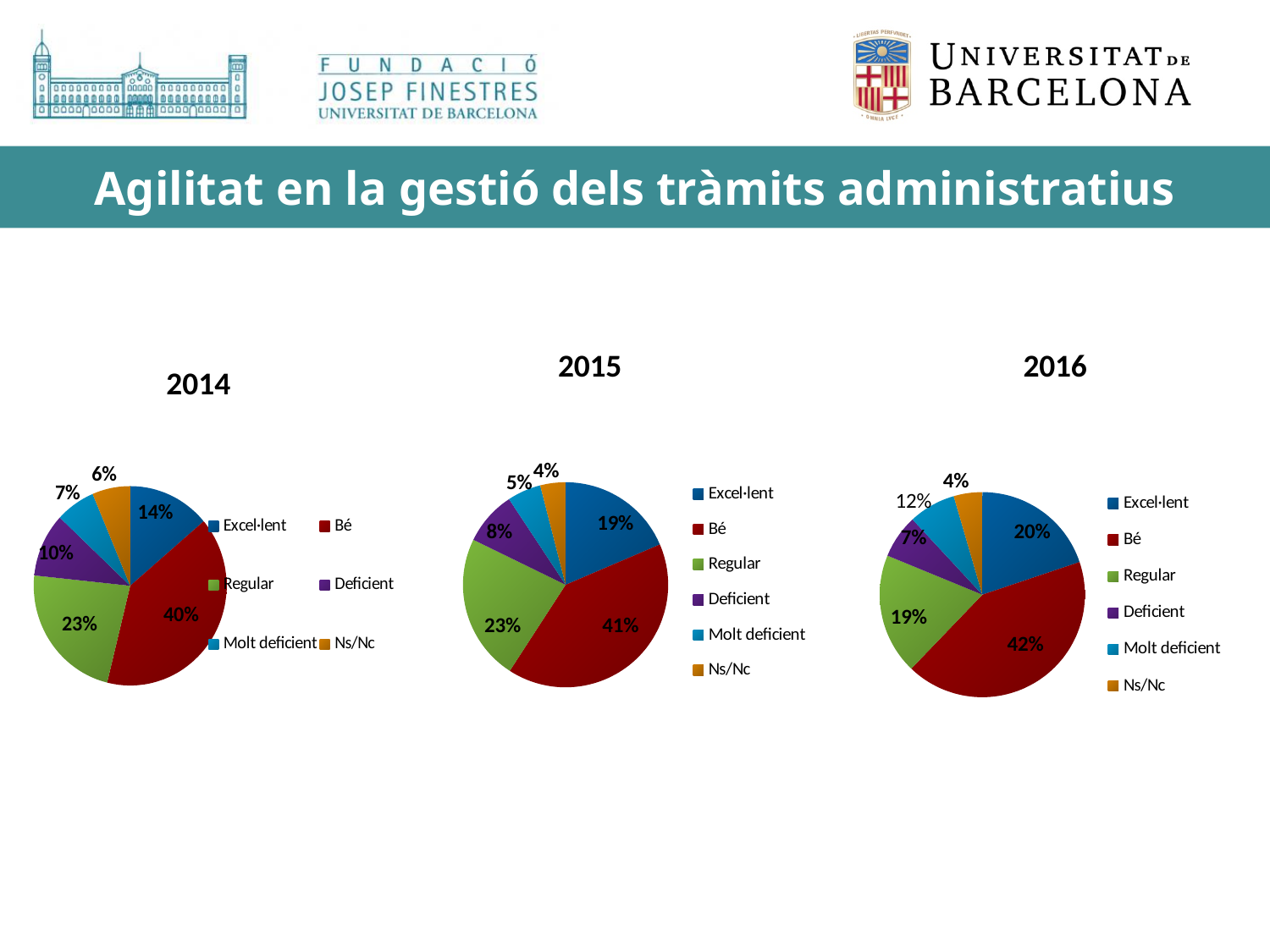
In the 2016 pie chart, what percentage is shown for Regular? 19% In the 2015 pie chart, what is the difference between the Bé share and the Regular share? 18% In the 2014 pie chart, which category has the smallest share? Ns/Nc In the 2016 pie chart, which category has the largest share? Bé In the 2014 pie chart, what percentage is shown for Bé? 40% Which is larger in the 2016 pie chart: the Molt deficient share or the Deficient share? Molt deficient How many categories does the legend of the 2015 pie chart list? 6 What kind of chart is used for the 2014 data? Pie chart In the 2015 pie chart, what is the difference between the Deficient share and the Molt deficient share? 3% In the 2014 pie chart, what percentage is shown for Deficient? 10% How many pie charts are shown on the slide? 3 In the 2015 pie chart, what percentage is shown for Excel·lent? 19%